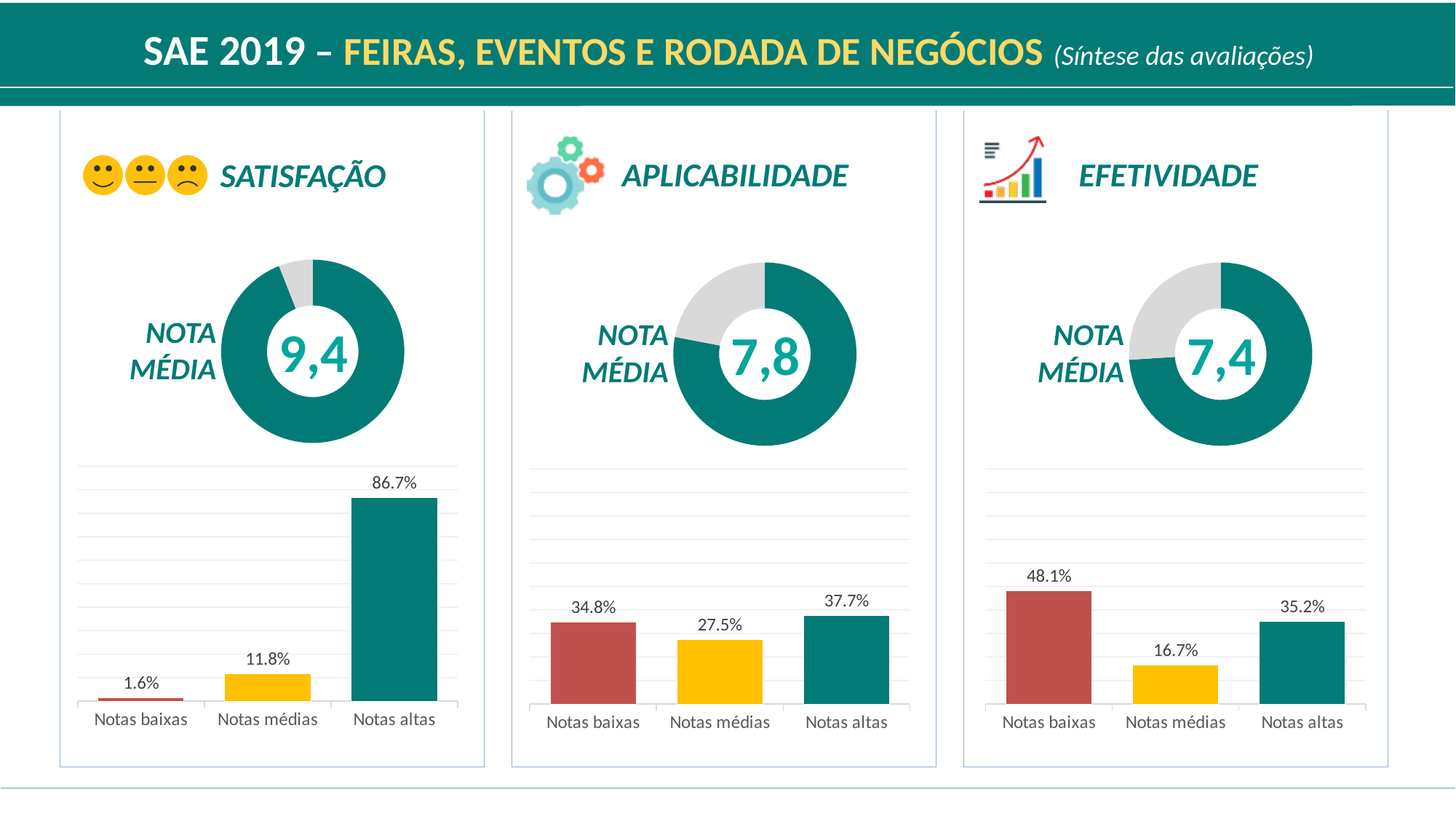
In the APLICABILIDADE bar chart, what is the difference between Notas altas and Notas médias? 10.2% How many categories does the APLICABILIDADE bar chart show? 3 In the SATISFAÇÃO bar chart, what is the difference between Notas altas and Notas médias? 74.9% What is the NOTA MÉDIA shown in the APLICABILIDADE donut chart? 7,8 In the EFETIVIDADE bar chart, which is larger: Notas baixas or Notas altas? Notas baixas In the SATISFAÇÃO bar chart, what is the value for Notas altas? 86.7% In the EFETIVIDADE bar chart, which category has the highest value? Notas baixas In the APLICABILIDADE bar chart, what is the value for Notas médias? 27.5% What is the NOTA MÉDIA shown in the EFETIVIDADE donut chart? 7,4 What kind of chart shows the NOTA MÉDIA value in the SATISFAÇÃO panel? Donut chart In the SATISFAÇÃO bar chart, what is the value for Notas baixas? 1.6% In the EFETIVIDADE bar chart, which category has the lowest value? Notas médias